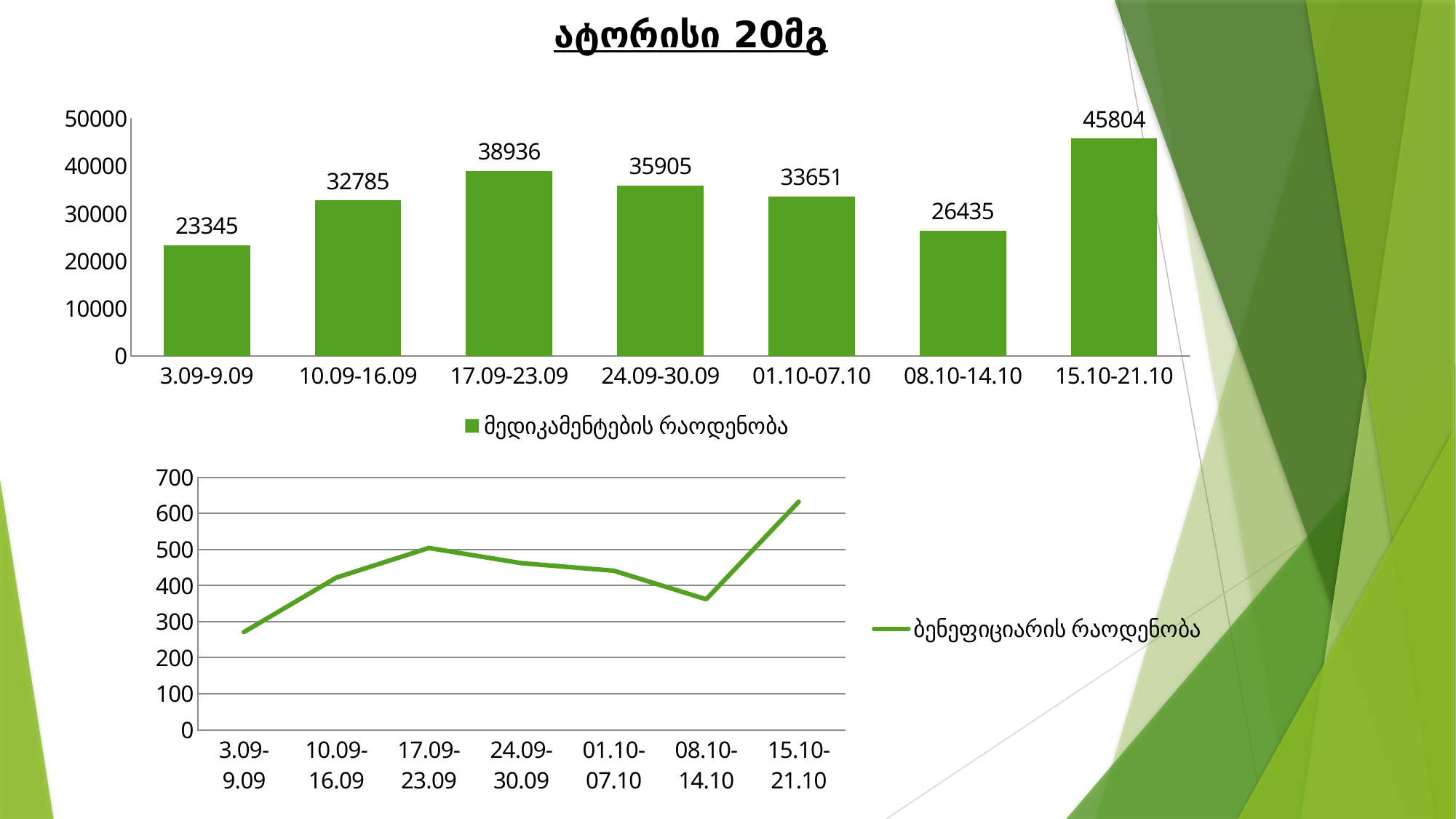
What kind of chart is the bottom chart on the slide? line chart In the top bar chart, what is the difference between the values for 15.10-21.10 and 3.09-9.09? 22459 How many periods are shown on the x axis of the top bar chart? 7 In the top bar chart, which period has the lowest value? 3.09-9.09 In the top bar chart, which is larger: the value for 24.09-30.09 or the value for 01.10-07.10? 24.09-30.09 In the top bar chart, what is the value for 08.10-14.10? 26435 In the bottom line chart, is the value for 15.10-21.10 greater or less than 600? greater In the top bar chart, which period has the highest value? 15.10-21.10 In the top bar chart, what is the value for 17.09-23.09? 38936 In the bottom line chart, is the value for 3.09-9.09 greater or less than 300? less What is the legend entry of the bottom line chart? ბენეფიციარის რაოდენობა In the bottom line chart, which period has the highest value? 15.10-21.10